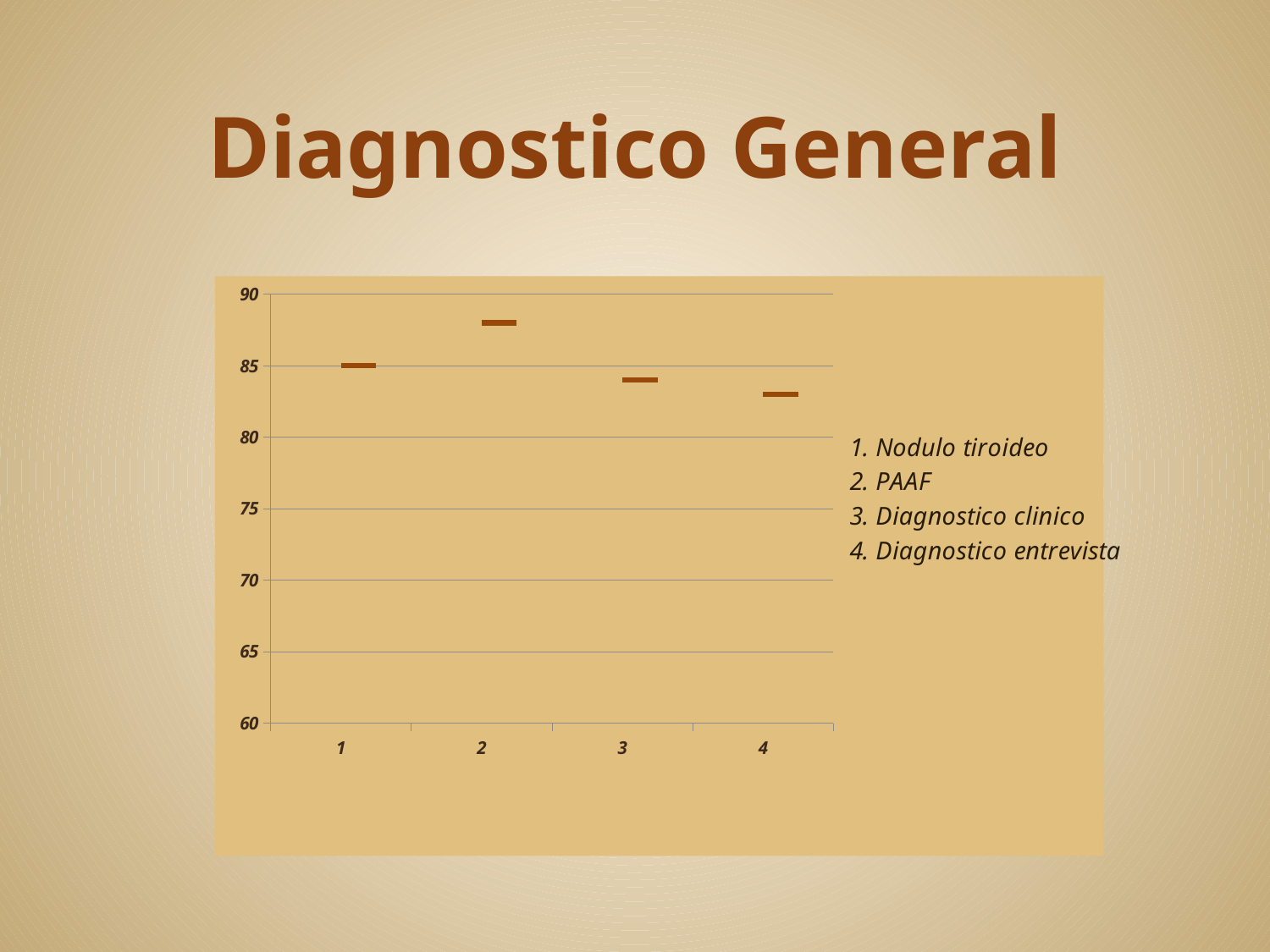
Is the value for category 3 (Diagnostico clinico) greater or less than 85? less Is the value for category 4 (Diagnostico entrevista) greater or less than 80? greater What is the value for category 1 (Nodulo tiroideo)? 85 What is the title of the slide containing the chart? Diagnostico General According to the key next to the chart, what does category 2 stand for? PAAF How many categories are plotted on the x axis? 4 Is the value for category 2 (PAAF) greater or less than 90? less Which category has the highest value? 2 (PAAF) Which has a larger value, category 2 (PAAF) or category 3 (Diagnostico clinico)? 2 (PAAF) Which category has the lowest value? 4 (Diagnostico entrevista) Which has a larger value, category 1 (Nodulo tiroideo) or category 4 (Diagnostico entrevista)? 1 (Nodulo tiroideo)